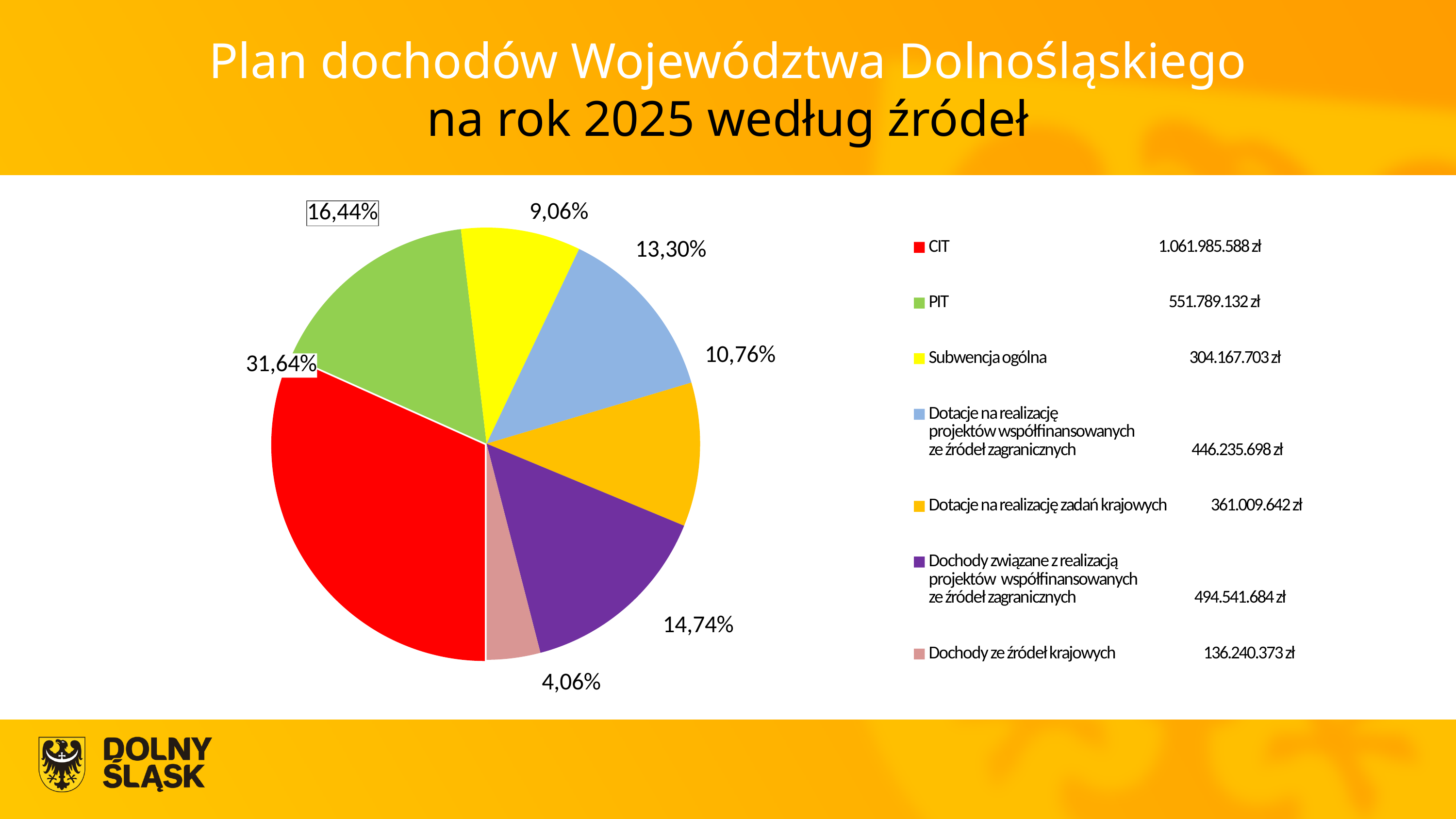
What percentage share does the Dochody ze źródeł krajowych slice have? 4,06% What is the difference in percentage points between the CIT share and the PIT share? 15,20 Which slice is larger: Subwencja ogólna or Dotacje na realizację zadań krajowych? Dotacje na realizację zadań krajowych Which source has the smallest share of the pie? Dochody ze źródeł krajowych What value in zł is listed for Dotacje na realizację zadań krajowych in the legend? 361.009.642 zł What percentage share does the CIT slice have? 31,64% What percentage share does the PIT slice have? 16,44% How many slices does the pie chart have? 7 Which source has the largest share of the pie? CIT What type of chart is shown on the slide? pie chart What value in zł is listed for CIT in the legend? 1.061.985.588 zł